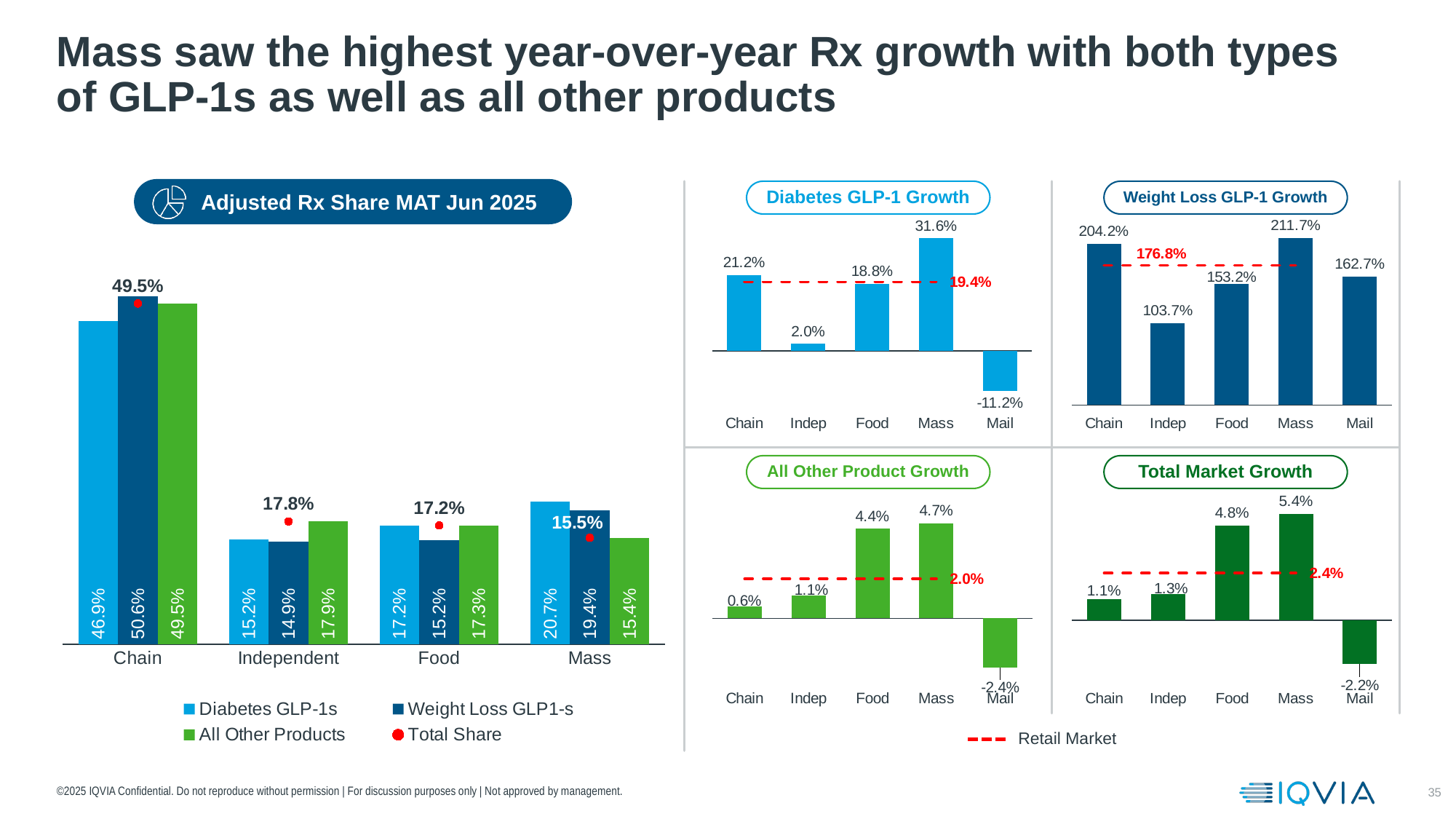
How many entries does the legend of the Adjusted Rx Share MAT Jun 2025 chart list? 4 In the All Other Product Growth chart, which is larger, the value for Food or the value for Mass? Mass How many channels are shown on the x axis of the Diabetes GLP-1 Growth chart? 5 In the Adjusted Rx Share MAT Jun 2025 chart, what is the Weight Loss GLP1-s share for Chain? 50.6% In the All Other Product Growth chart, what value is shown for the Retail Market dashed line? 2.0% In the Adjusted Rx Share MAT Jun 2025 chart, what is the Total Share for Independent? 17.8% In the Diabetes GLP-1 Growth chart, what is the growth value for Mail? -11.2% In the Weight Loss GLP-1 Growth chart, which channel has the highest growth? Mass In the Total Market Growth chart, which channel has the lowest growth? Mail What kind of chart is the Total Market Growth chart? Bar chart In the four growth charts on the right, what does the red dashed line represent? Retail Market In the Weight Loss GLP-1 Growth chart, how much higher is the Mass value than the Chain value? 7.5 percentage points